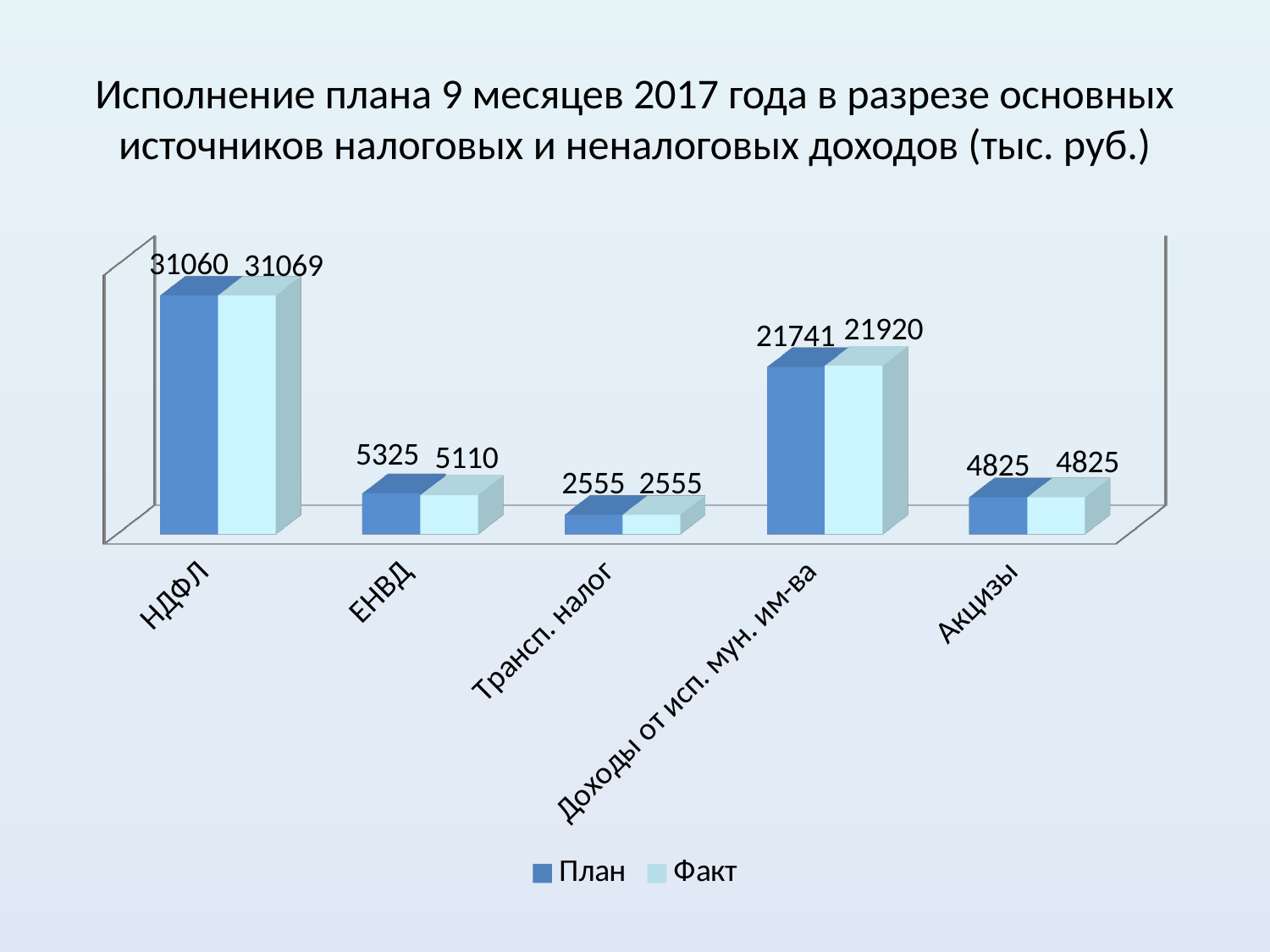
What is the Факт value for ЕНВД? 5110 How many categories are shown on the x axis? 5 Which category has the lowest Факт value? Трансп. налог What is the difference between the Факт and План values for Доходы от исп. мун. им-ва? 179 Which category has the highest План value? НДФЛ What is the Факт value for Доходы от исп. мун. им-ва? 21920 What are the two series named in the legend? План and Факт What kind of chart is shown on the slide? Bar chart Which is larger for ЕНВД, the План value or the Факт value? План What is the План value for НДФЛ? 31060 What is the difference between the План and Факт values for ЕНВД? 215 How many series does the legend list? 2